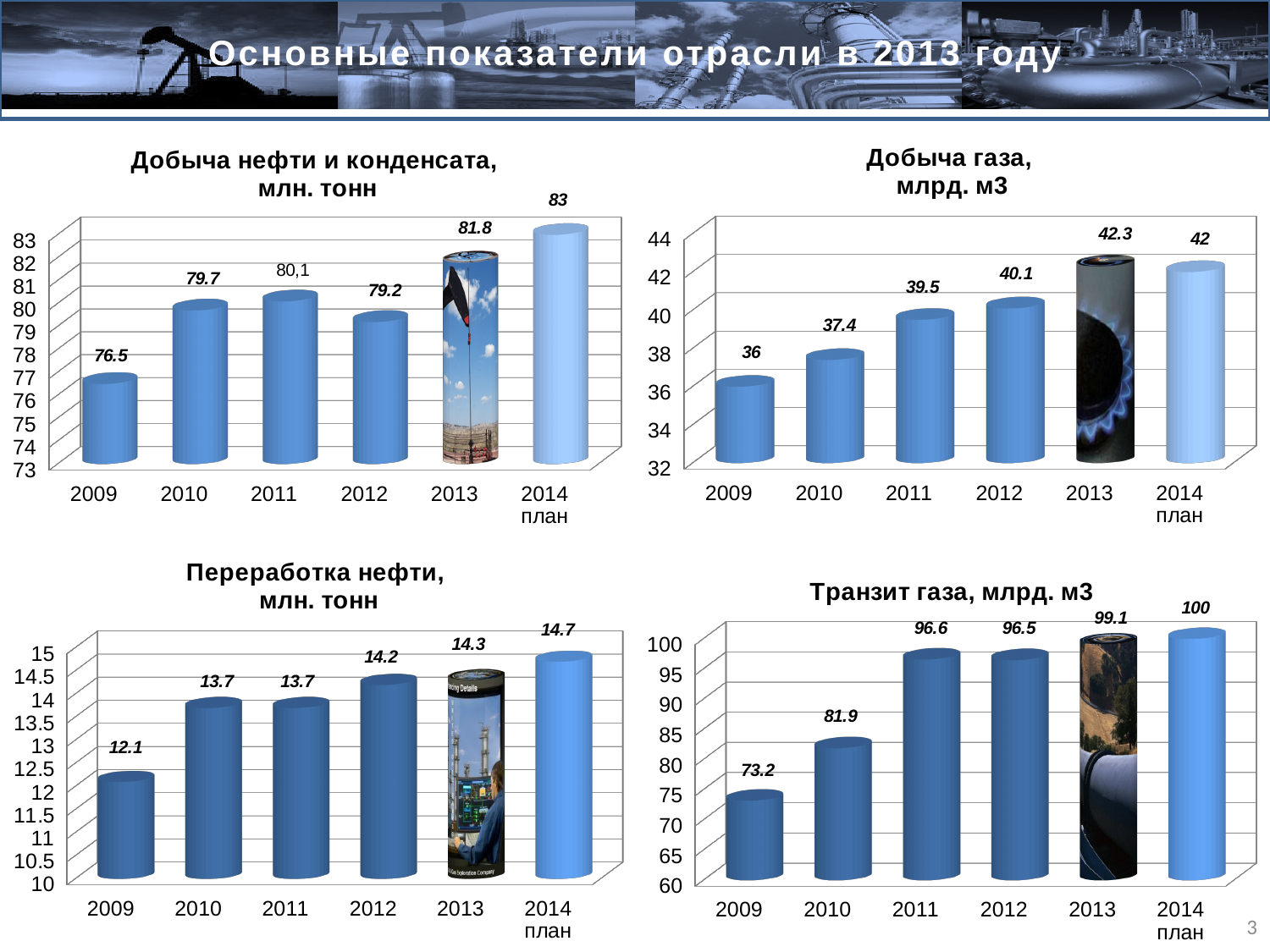
In the chart 'Добыча нефти и конденсата, млн. тонн', what is the value for 2009? 76.5 In the chart 'Добыча газа, млрд. м3', what is the difference between the 2013 value and the 2009 value? 6.3 In the chart 'Переработка нефти, млн. тонн', which year has the lowest value? 2009 In the chart 'Добыча нефти и конденсата, млн. тонн', what is the value for 2013? 81.8 In the chart 'Транзит газа, млрд. м3', what is the difference between the 2014 план value and the 2009 value? 26.8 In the chart 'Транзит газа, млрд. м3', which is larger, the value for 2011 or the value for 2010? 2011 In the chart 'Переработка нефти, млн. тонн', what is the value for 2014 план? 14.7 In the chart 'Добыча газа, млрд. м3', which year has the highest value? 2013 In the chart 'Транзит газа, млрд. м3', what is the value for 2010? 81.9 How many categories (years) are shown on the x axis of the chart 'Переработка нефти, млн. тонн'? 6 In the chart 'Добыча газа, млрд. м3', what is the value for 2011? 39.5 What type of chart is 'Добыча газа, млрд. м3'? Bar chart